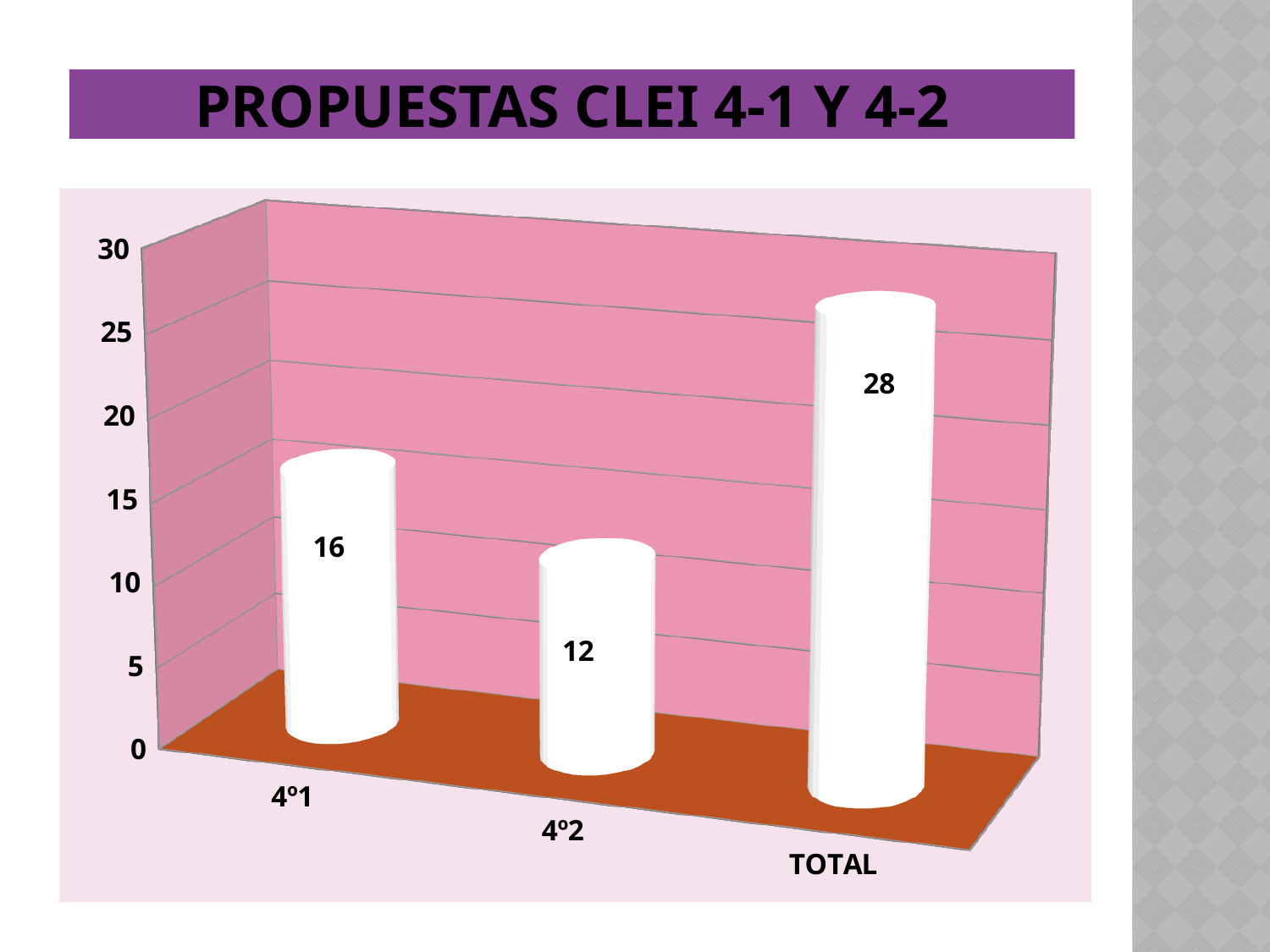
What is the title of the slide? PROPUESTAS CLEI 4-1 Y 4-2 Which category has the lowest value? 4º2 What is the value for 4º2? 12 Is the value for TOTAL greater or less than 25? greater What is the difference between the values for 4º1 and 4º2? 4 Which category has the highest value? TOTAL What is the value for 4º1? 16 What is the difference between the values for TOTAL and 4º1? 12 How many categories are shown on the x axis? 3 What is the value for TOTAL? 28 What kind of chart is shown on the slide? bar chart Which is larger, the value for 4º1 or the value for 4º2? 4º1